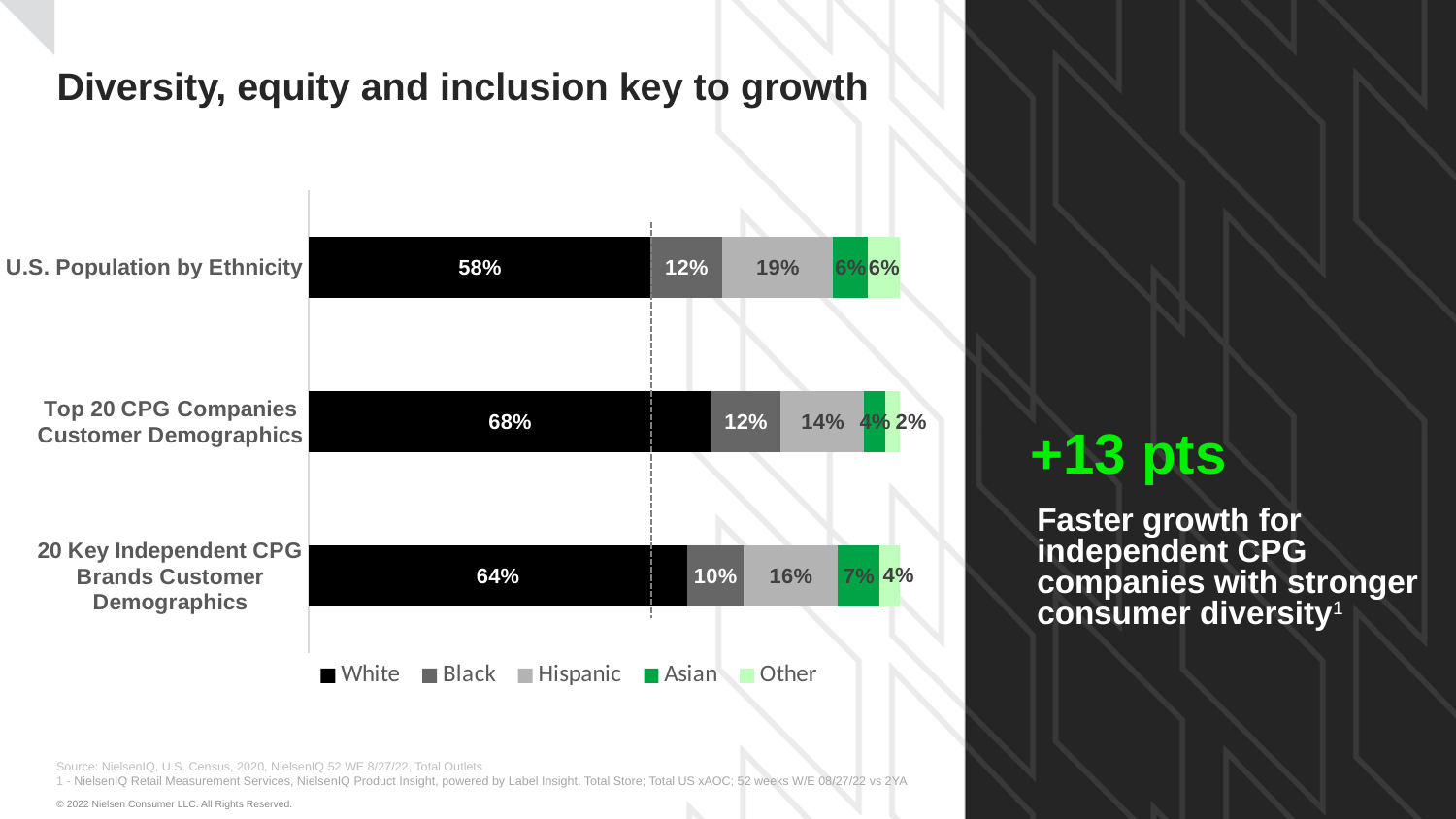
What is the difference between the White share for Top 20 CPG Companies Customer Demographics and for U.S. Population by Ethnicity? 10% What is the Other share for Top 20 CPG Companies Customer Demographics? 2% Which is larger: the Hispanic share for U.S. Population by Ethnicity or for 20 Key Independent CPG Brands Customer Demographics? U.S. Population by Ethnicity Which series is shown in black in the chart? White What is the White share for U.S. Population by Ethnicity? 58% What is the Hispanic share for Top 20 CPG Companies Customer Demographics? 14% Which category has the lowest Black share? 20 Key Independent CPG Brands Customer Demographics Which category has the highest White share? Top 20 CPG Companies Customer Demographics What is the Asian share for 20 Key Independent CPG Brands Customer Demographics? 7% How many series does the legend list? 5 How many categories (bars) are plotted in the chart? 3 What kind of chart is shown on the slide? Stacked bar chart